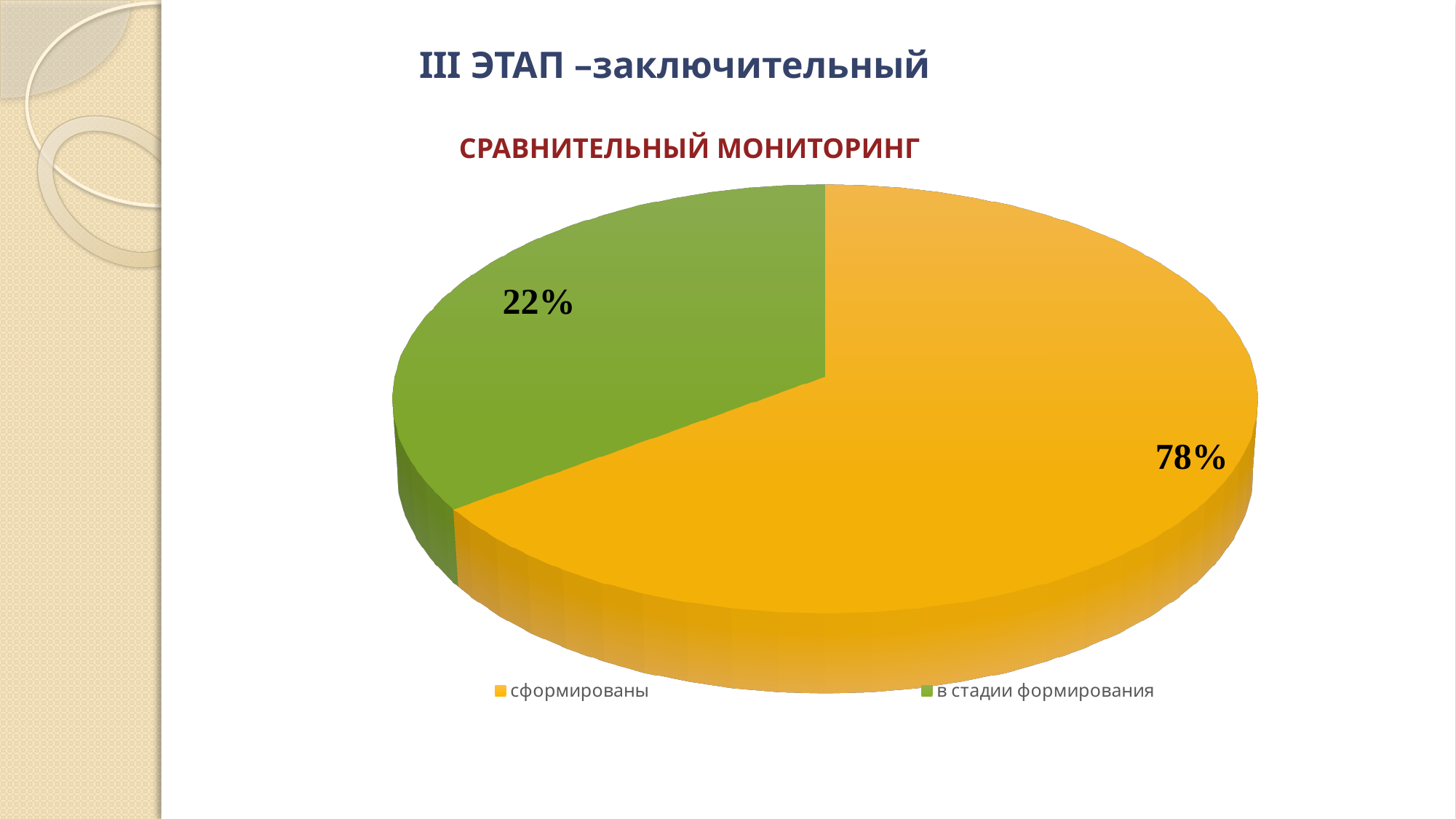
Which category has the smallest share of the pie? в стадии формирования What is the difference between the shares for сформированы and в стадии формирования? 56% What is the title of the chart? СРАВНИТЕЛЬНЫЙ МОНИТОРИНГ Which category has the largest share of the pie? сформированы How many entries does the legend list? 2 What is the value for сформированы? 78% How many slices does the pie chart have? 2 What share of the pie does the green slice represent? 22% What is the value for в стадии формирования? 22% What kind of chart is shown on the slide? pie chart Which is larger, the share for сформированы or for в стадии формирования? сформированы What colour is the slice for сформированы? orange